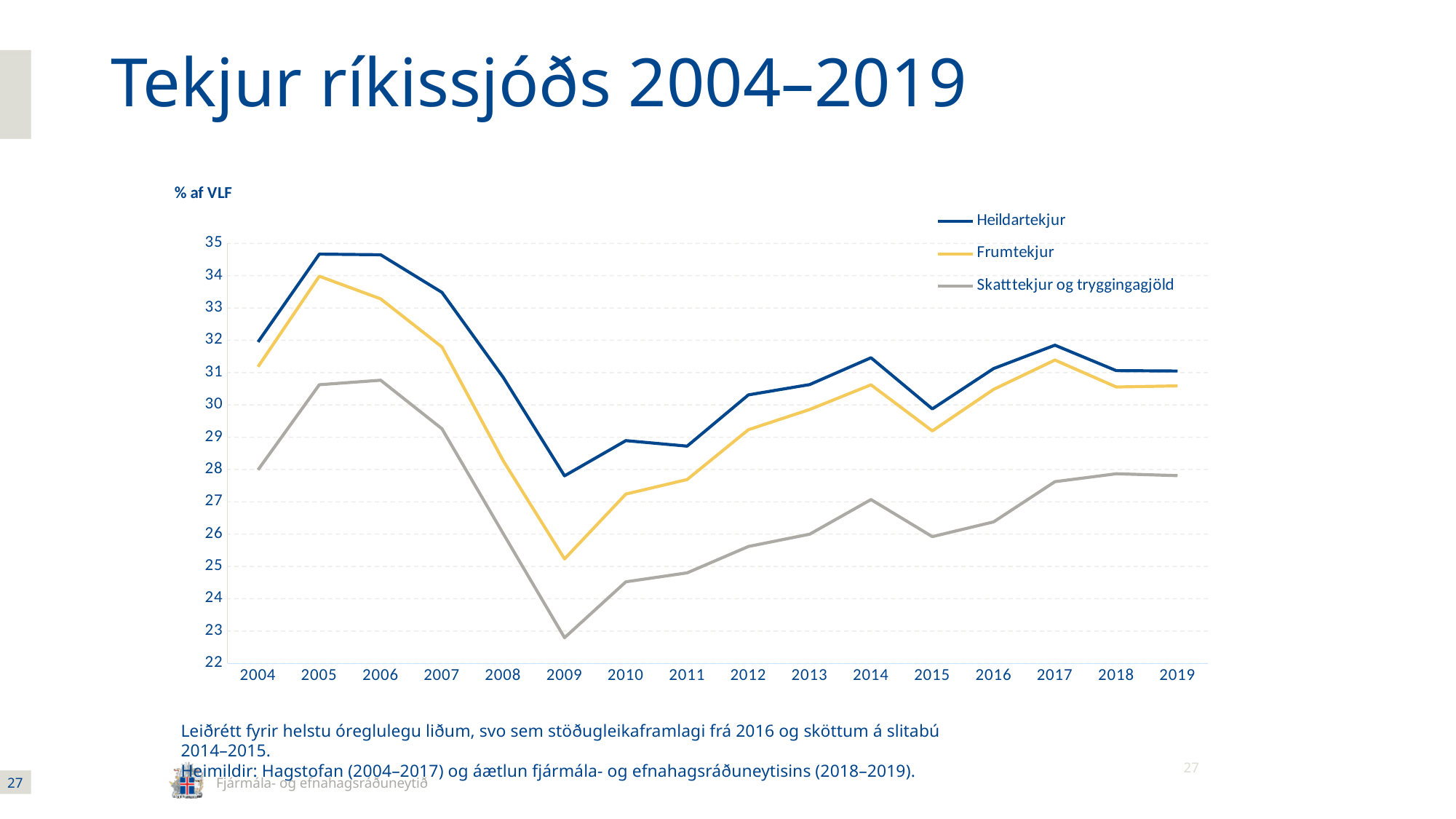
In 2014, which is larger: Heildartekjur or Skatttekjur og tryggingagjöld? Heildartekjur In which year is Frumtekjur at its highest? 2005 Is the value for Skatttekjur og tryggingagjöld in 2009 greater or less than 24? less What kind of chart is shown on the slide? line chart In which year is Heildartekjur at its lowest? 2009 How many series does the legend list? 3 Is the value for Frumtekjur in 2005 greater or less than 33? greater How many years are plotted along the x axis? 16 Does Heildartekjur rise or fall from 2006 to 2009? fall Is the value for Heildartekjur in 2009 greater or less than 29? less What unit label is shown above the y axis? % af VLF In which year is Skatttekjur og tryggingagjöld at its lowest? 2009